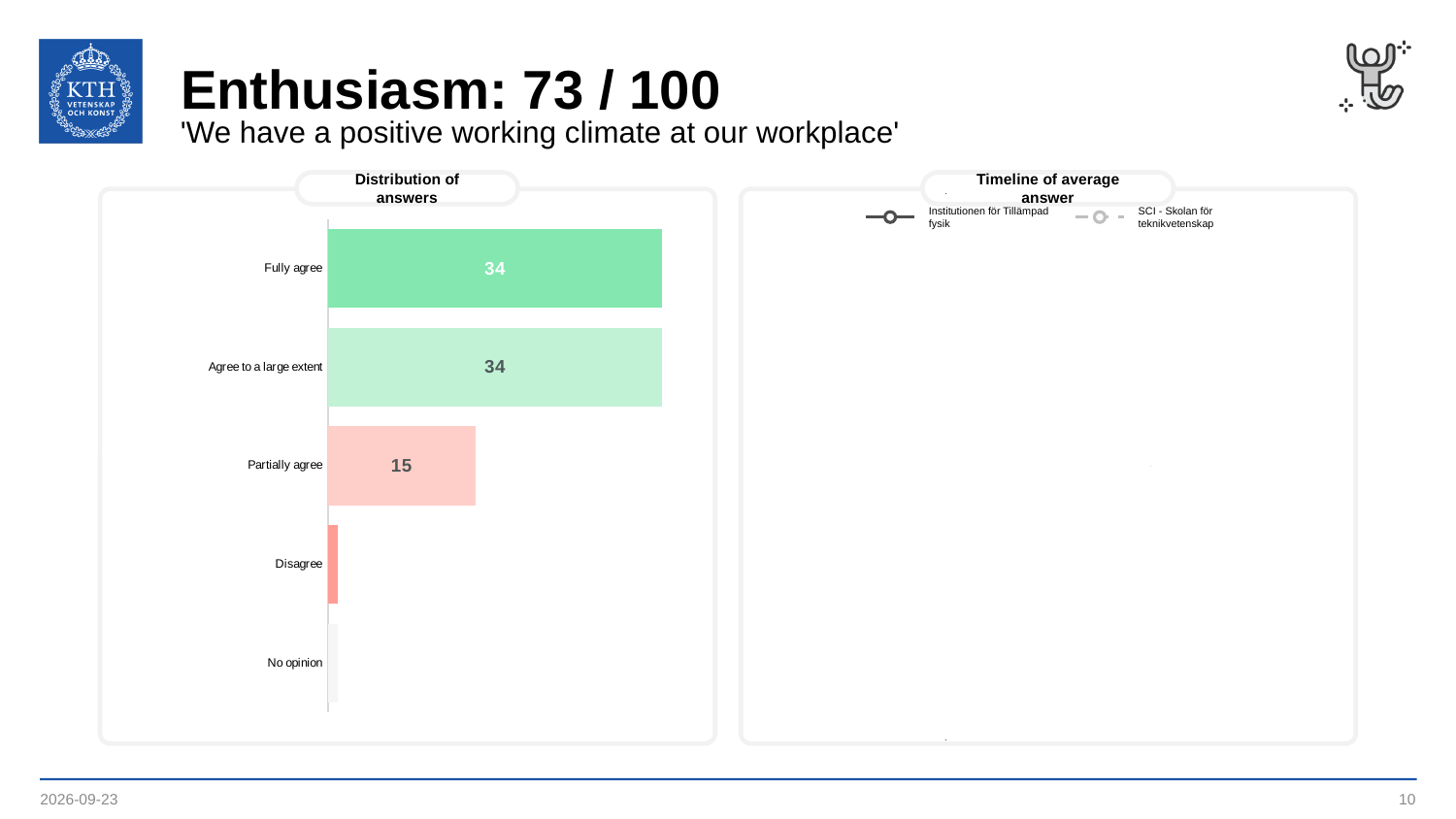
In the 'Distribution of answers' chart, what is the value for 'Agree to a large extent'? 34 In the 'Distribution of answers' chart, what is the value for 'Fully agree'? 34 What kind of chart is the 'Distribution of answers' chart? Bar chart In the 'Distribution of answers' chart, which is larger: the value for 'Partially agree' or the value for 'Disagree'? Partially agree In the 'Timeline of average answer' chart, which series is shown with a dashed line in the legend? SCI - Skolan för teknikvetenskap In the 'Distribution of answers' chart, what is the difference between the values for 'Fully agree' and 'Partially agree'? 19 How many categories are shown in the 'Distribution of answers' chart? 5 How many series does the legend of the 'Timeline of average answer' chart list? 2 In the 'Distribution of answers' chart, do the values for 'Fully agree' and 'Agree to a large extent' have the same value? Yes In the 'Distribution of answers' chart, which is larger: the value for 'Agree to a large extent' or the value for 'Partially agree'? Agree to a large extent In the 'Distribution of answers' chart, what is the value for 'Partially agree'? 15